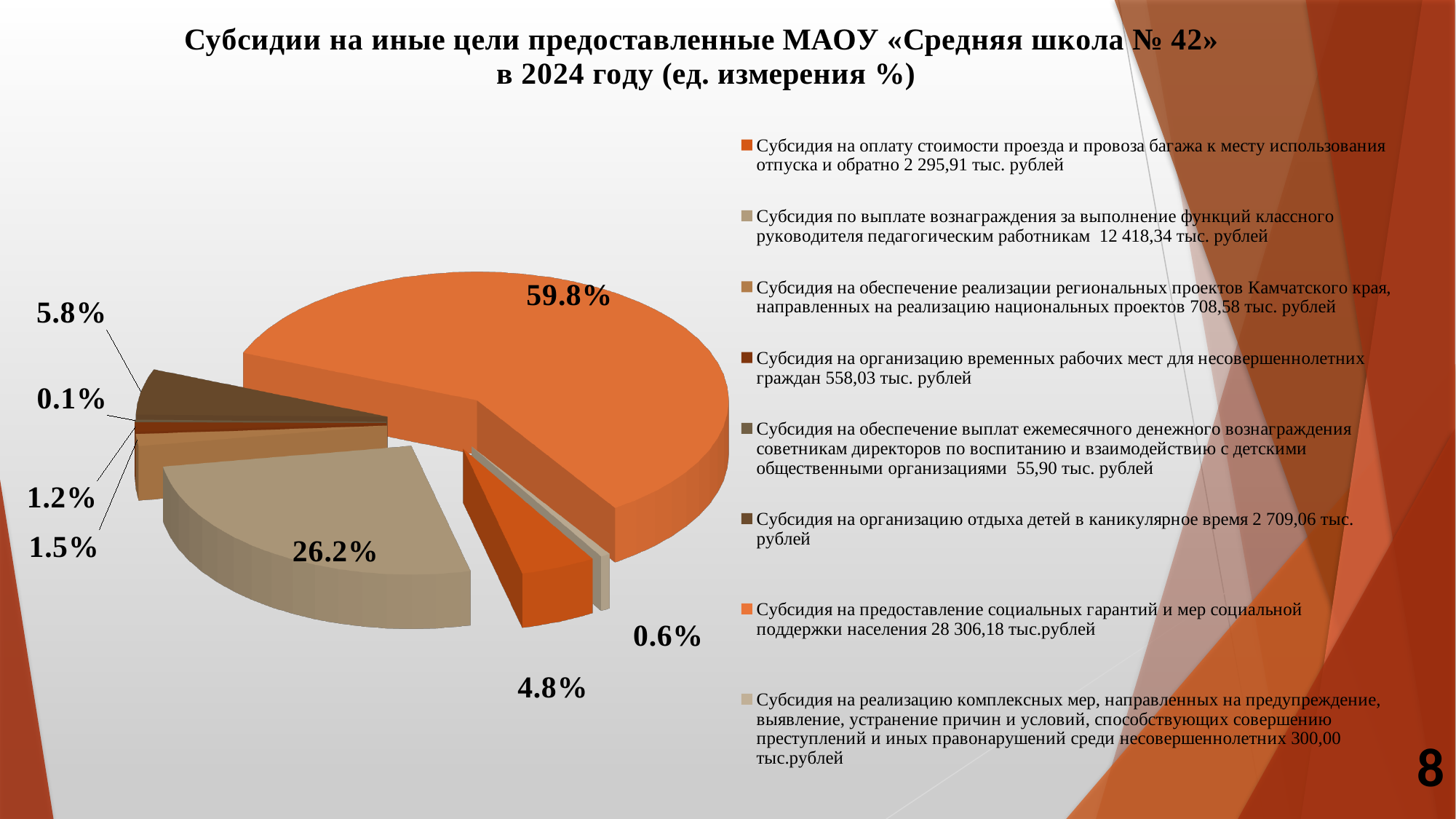
What share of the pie does the subsidy for children's holiday recreation (Субсидия на организацию отдыха детей в каникулярное время) have? 5.8% What is the largest percentage shown on the pie chart? 59.8% Which subsidy has the largest share of the pie? Субсидия на предоставление социальных гарантий и мер социальной поддержки населения What year does the chart title say the subsidies were provided in? 2024 Which is larger: the slice labelled 1.5% or the slice labelled 1.2%? 1.5% According to the legend, what amount in thousand rubles corresponds to the subsidy for social guarantees and social support of the population? 28 306,18 тыс.рублей What is the difference in percentage points between the largest slice (59.8%) and the second largest slice (26.2%)? 33.6 What kind of chart is shown on the slide? pie chart Which subsidy has the smallest share of the pie? Субсидия на обеспечение выплат ежемесячного денежного вознаграждения советникам директоров по воспитанию What share of the pie does the subsidy for travel and baggage to the vacation place (Субсидия на оплату стоимости проезда и провоза багажа) have? 4.8% How many slices does the pie chart have? 8 What share of the pie does the subsidy for class teacher remuneration (Субсидия по выплате вознаграждения за выполнение функций классного руководителя) have? 26.2%